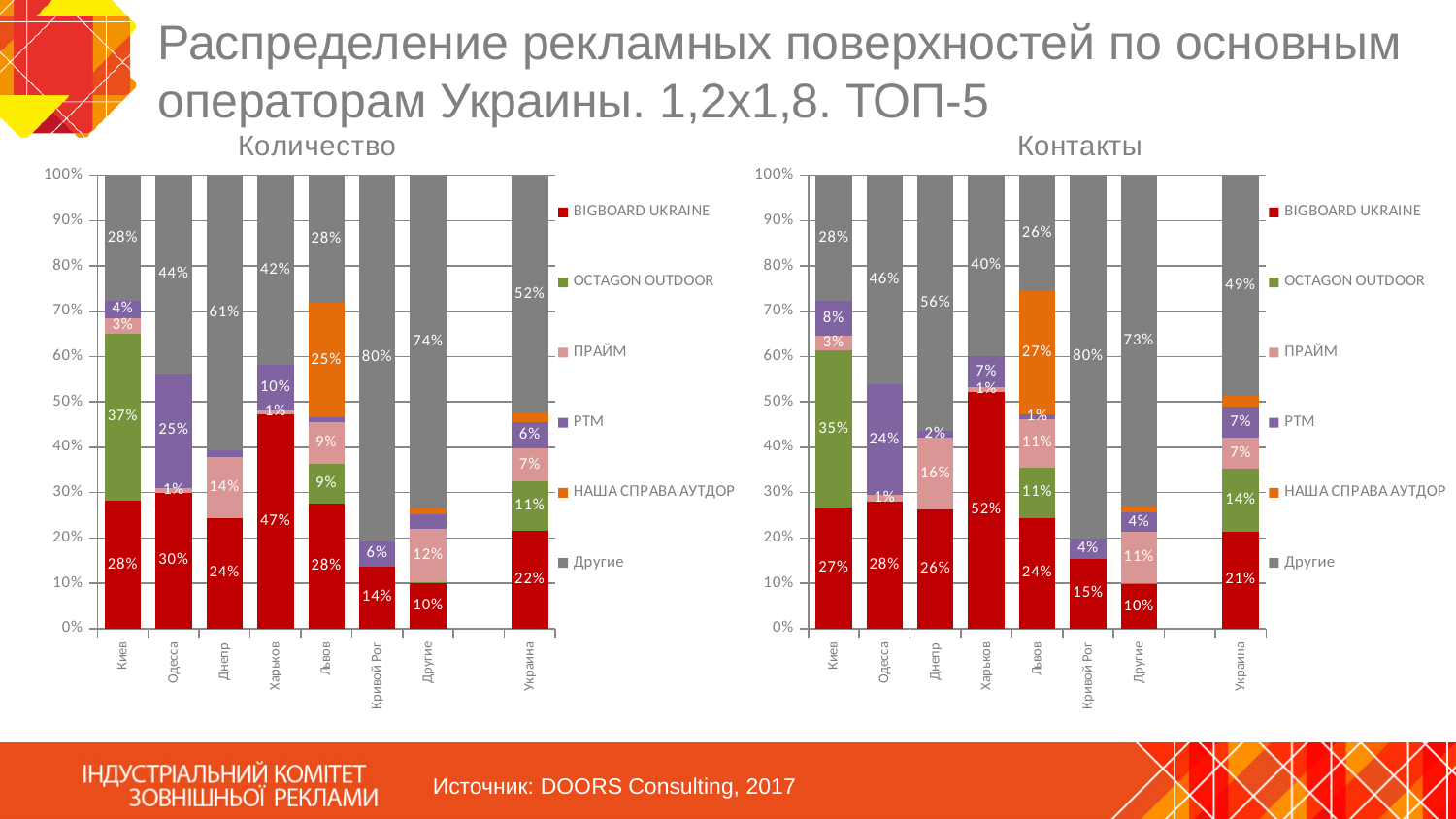
In the "Контакты" chart, which category has the lowest share for BIGBOARD UKRAINE? Другие In the "Контакты" chart, what is the share of Другие (other operators) for Кривой Рог? 80% How many categories are shown on the x axis of the "Количество" chart? 8 In the "Количество" chart, what is the share of BIGBOARD UKRAINE for Харьков? 47% In the "Контакты" chart, which is larger: the РТМ share for Киев or the РТМ share for Одесса? Одесса In the "Контакты" chart, what is the share of OCTAGON OUTDOOR for Украина? 14% In the "Количество" chart, which category has the highest share for BIGBOARD UKRAINE? Харьков In the "Количество" chart, what is the difference between the BIGBOARD UKRAINE share for Одесса and for Днепр? 6% What type of chart is the "Количество" chart? stacked bar chart In the "Количество" chart, what is the share of OCTAGON OUTDOOR for Киев? 37% How many series does the legend of the "Контакты" chart list? 6 In the "Контакты" chart, what is the share of НАША СПРАВА АУТДОР for Львов? 27%